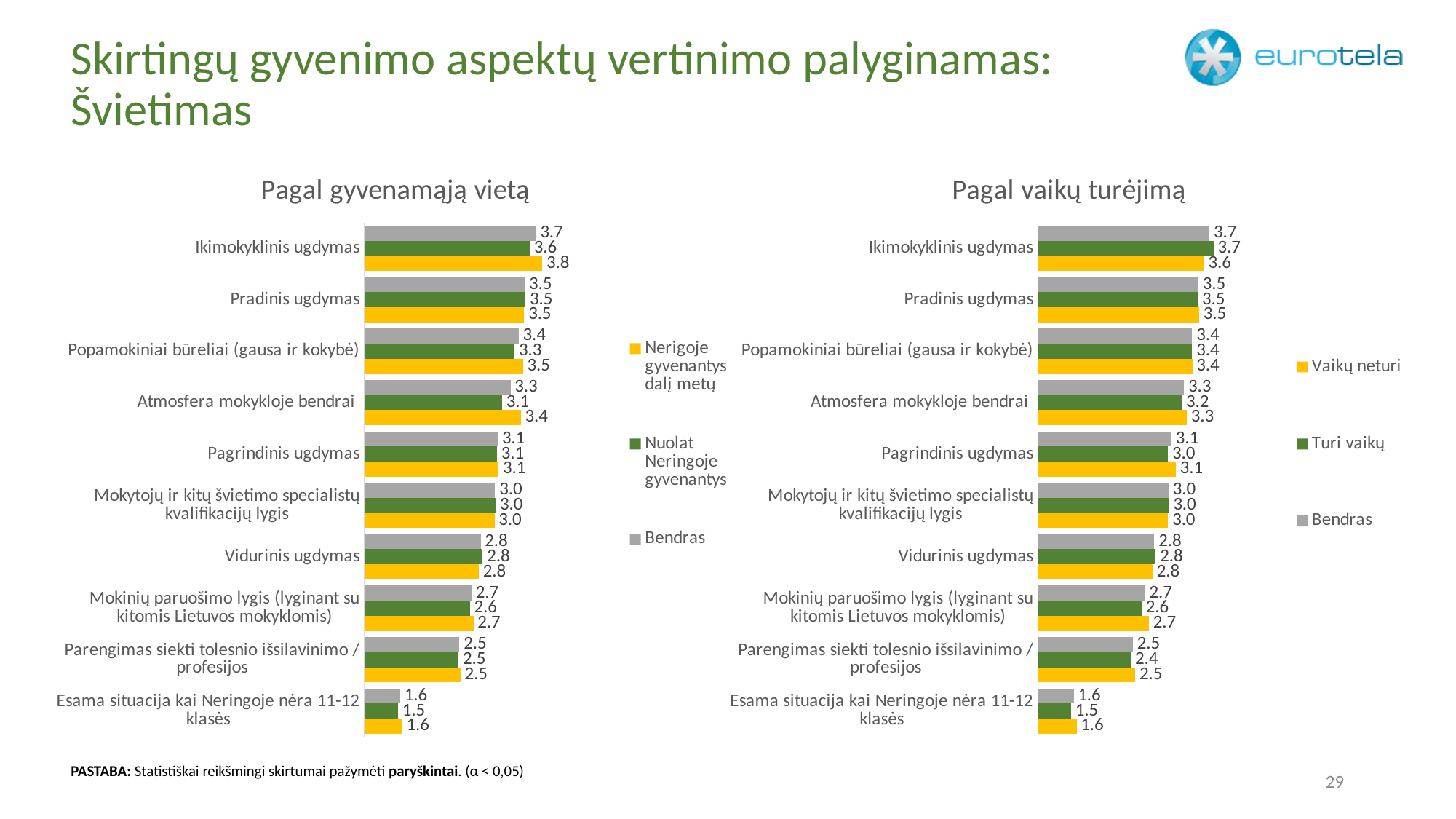
In the 'Pagal gyvenamąją vietą' chart, what is the value for 'Nerigoje gyvenantys dalį metų' for Ikimokyklinis ugdymas? 3.8 In the 'Pagal gyvenamąją vietą' chart, what is the 'Nuolat Neringoje gyvenantys' value for Atmosfera mokykloje bendrai? 3.1 In the 'Pagal vaikų turėjimą' chart, what is the 'Turi vaikų' value for Parengimas siekti tolesnio išsilavinimo / profesijos? 2.4 How many series does the legend of the 'Pagal vaikų turėjimą' chart list? 3 In the 'Pagal vaikų turėjimą' chart, which is larger for Pagrindinis ugdymas: 'Vaikų neturi' or 'Turi vaikų'? Vaikų neturi In the 'Pagal gyvenamąją vietą' chart, what is the difference between the 'Nerigoje gyvenantys dalį metų' and 'Nuolat Neringoje gyvenantys' values for Atmosfera mokykloje bendrai? 0.3 In the 'Pagal vaikų turėjimą' chart, what is the 'Vaikų neturi' value for Ikimokyklinis ugdymas? 3.6 In the 'Pagal gyvenamąją vietą' chart, which category has the lowest 'Bendras' value? Esama situacija kai Neringoje nėra 11-12 klasės What type of chart is 'Pagal gyvenamąją vietą'? Bar chart In the 'Pagal vaikų turėjimą' chart, which category has the highest 'Bendras' value? Ikimokyklinis ugdymas In the 'Pagal vaikų turėjimą' chart, which series is shown in yellow? Vaikų neturi How many categories are shown in the 'Pagal gyvenamąją vietą' chart? 10